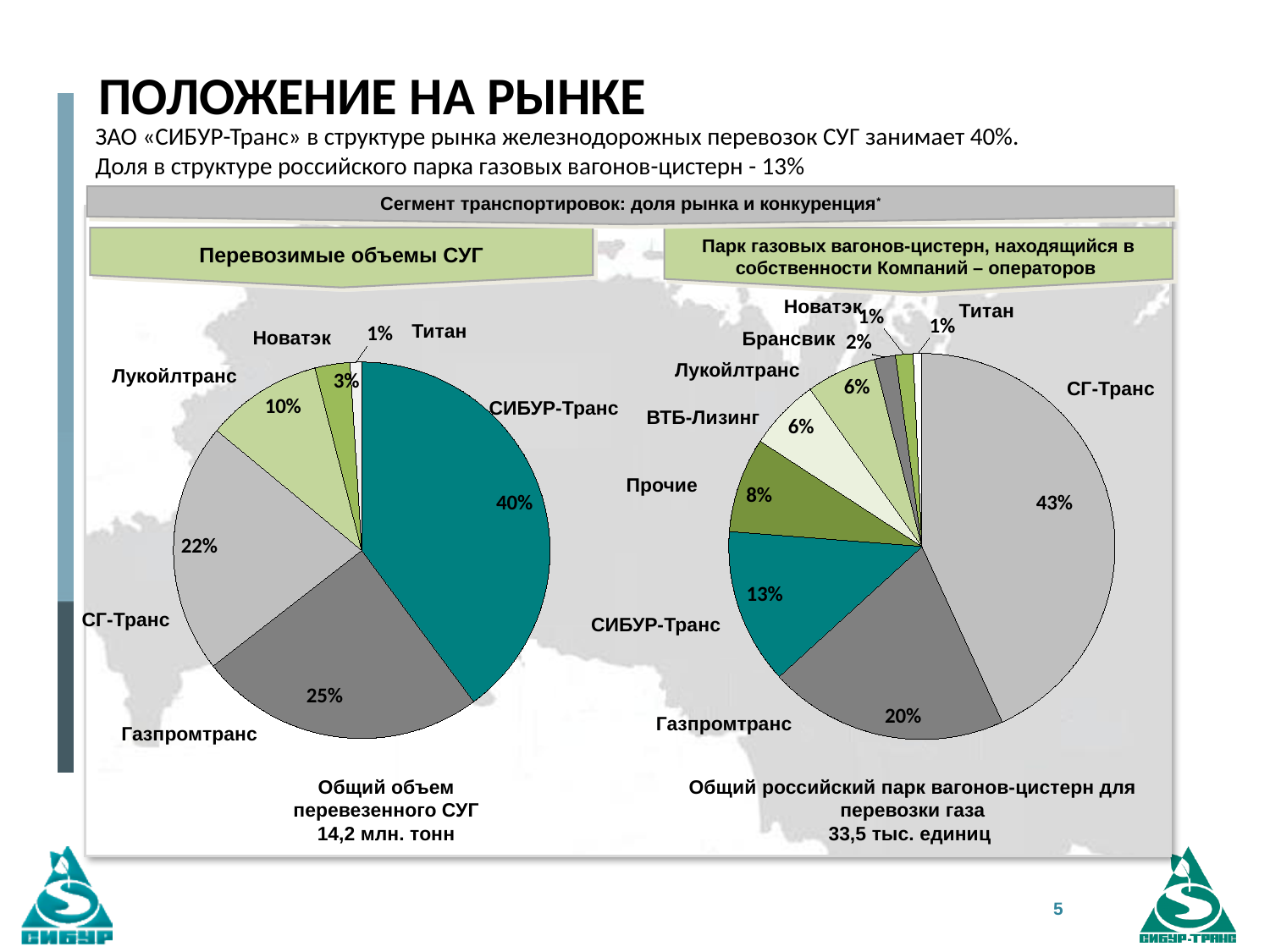
In the left pie chart (Перевозимые объемы СУГ), what share does Газпромтранс have? 25% In the left pie chart (Перевозимые объемы СУГ), what is the difference between the shares of СГ-Транс and Лукойлтранс? 12% In the right pie chart (Парк газовых вагонов-цистерн), what is the difference between the shares of СГ-Транс and Газпромтранс? 23% In the left pie chart (Перевозимые объемы СУГ), which company has the largest share? СИБУР-Транс In the left pie chart (Перевозимые объемы СУГ), which company has the smallest share? Титан In the right pie chart (Парк газовых вагонов-цистерн), what share does СГ-Транс have? 43% In the left pie chart (Перевозимые объемы СУГ), how many slices are there? 6 What type of charts are shown on the slide? Pie charts In the right pie chart (Парк газовых вагонов-цистерн), how many slices are there? 9 In the right pie chart (Парк газовых вагонов-цистерн), what share does СИБУР-Транс have? 13% In the left pie chart (Перевозимые объемы СУГ), what share does СИБУР-Транс have? 40% In the right pie chart (Парк газовых вагонов-цистерн), which is larger: the share of Газпромтранс or the share of Прочие? Газпромтранс